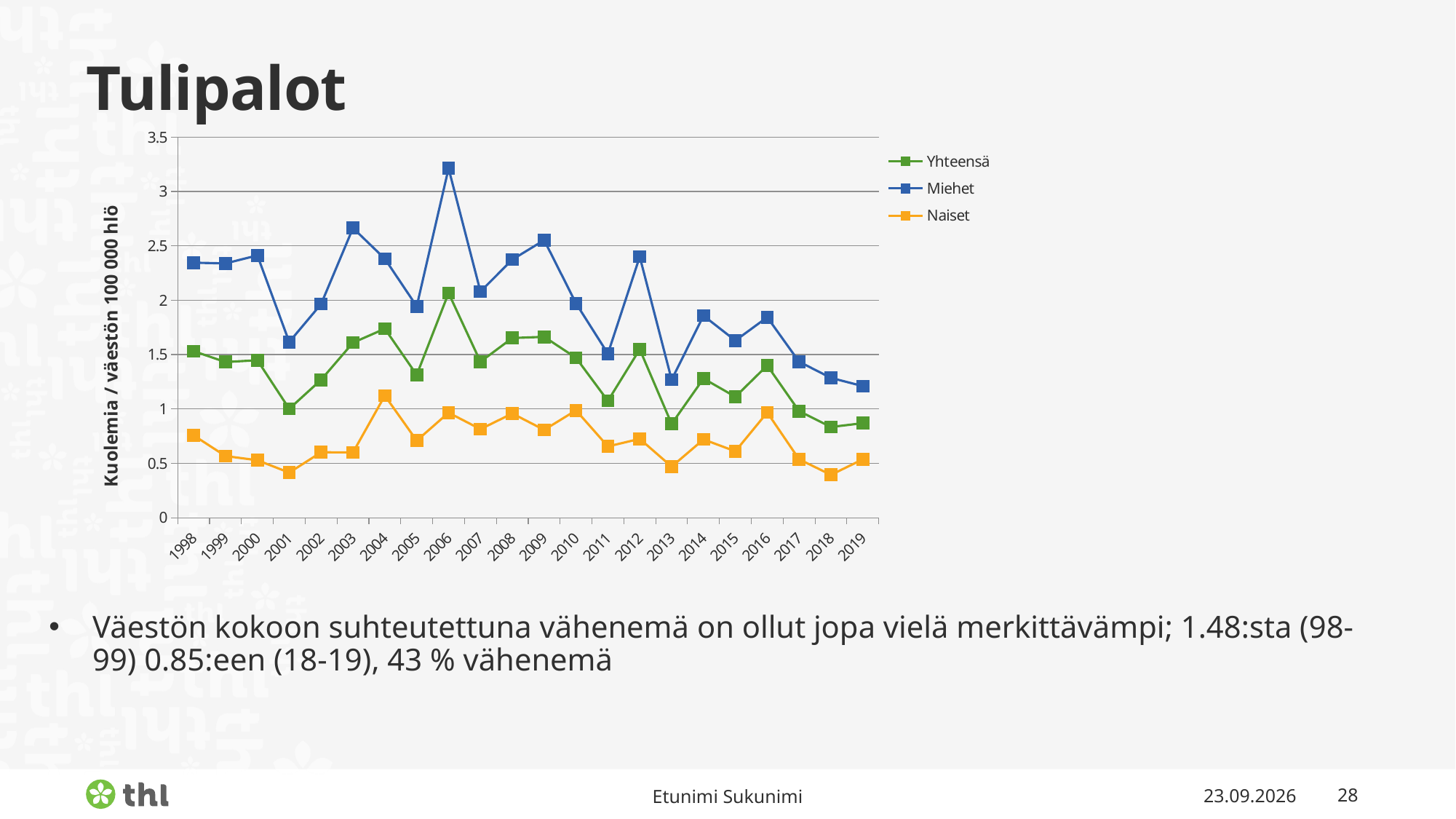
Is the value for Naiset in 2004 greater or less than 1? greater In which year does the Miehet series reach its highest value? 2006 Does the Yhteensä series overall rise or fall from 1998 to 2019? fall Is the value for Miehet in 2013 greater or less than 1.5? less How many series does the legend list? 3 Is the value for Yhteensä in 2006 greater or less than 2? greater Which is larger in 2010, the value for Miehet or the value for Naiset? Miehet How many years are plotted along the x axis? 22 What kind of chart is shown on the slide? line chart In which year does the Yhteensä series reach its highest value? 2006 What is the label on the vertical axis of the chart? Kuolemia / väestön 100 000 hlö